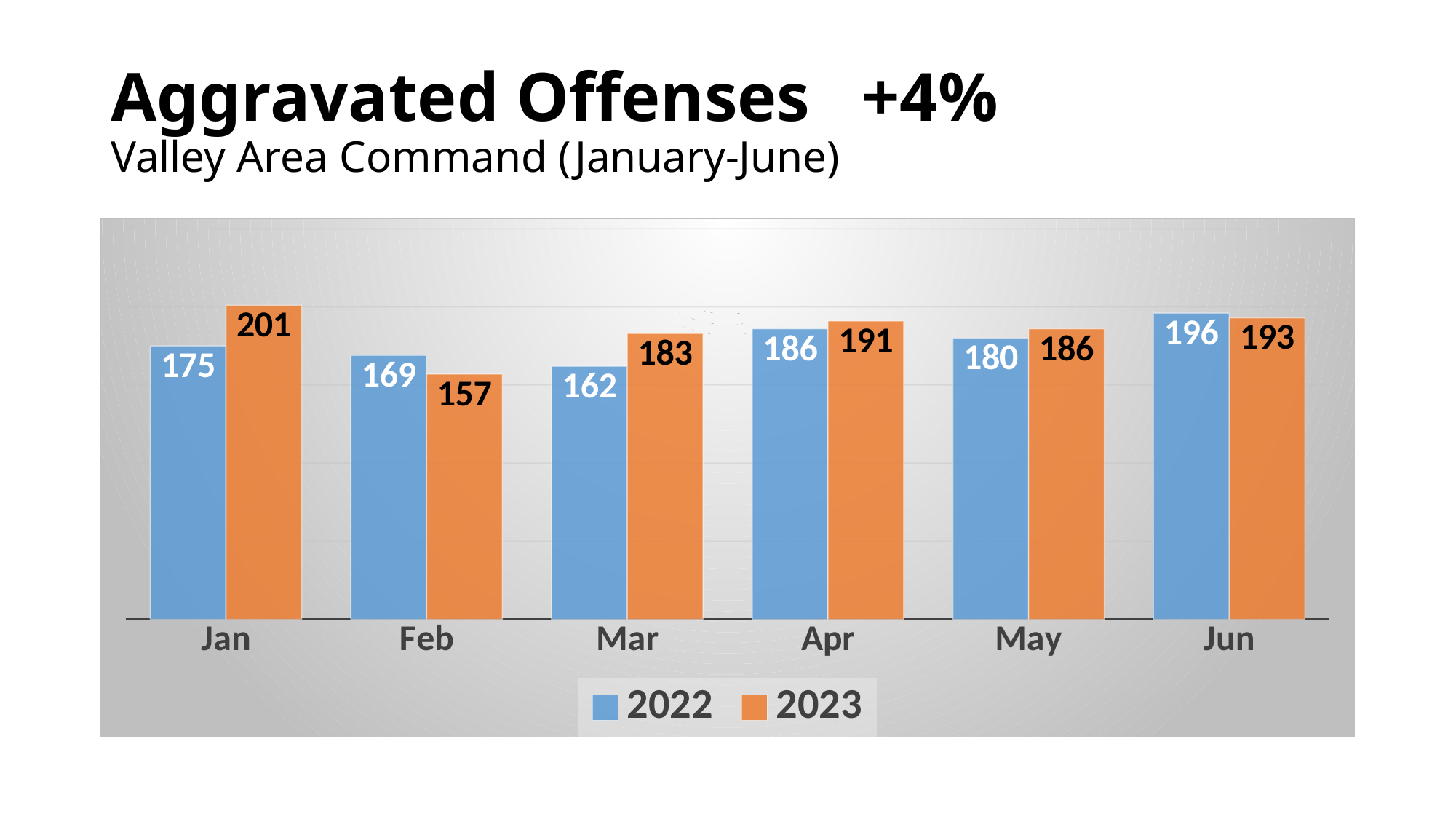
What is the value for 2023 in Feb? 157 How many series does the legend list? 2 What is the value for 2022 in Mar? 162 How many months are shown on the x axis? 6 What is the difference between the 2023 and 2022 values in Jan? 26 What kind of chart is shown on the slide? Bar chart What is the difference between the 2023 and 2022 values in Mar? 21 Which month has the lowest value for 2023? Feb What is the value for 2023 in Jan? 201 What percentage change is shown next to the chart title? +4% Which month has the highest value for 2022? Jun Which is larger in Jun, the 2022 value or the 2023 value? 2022